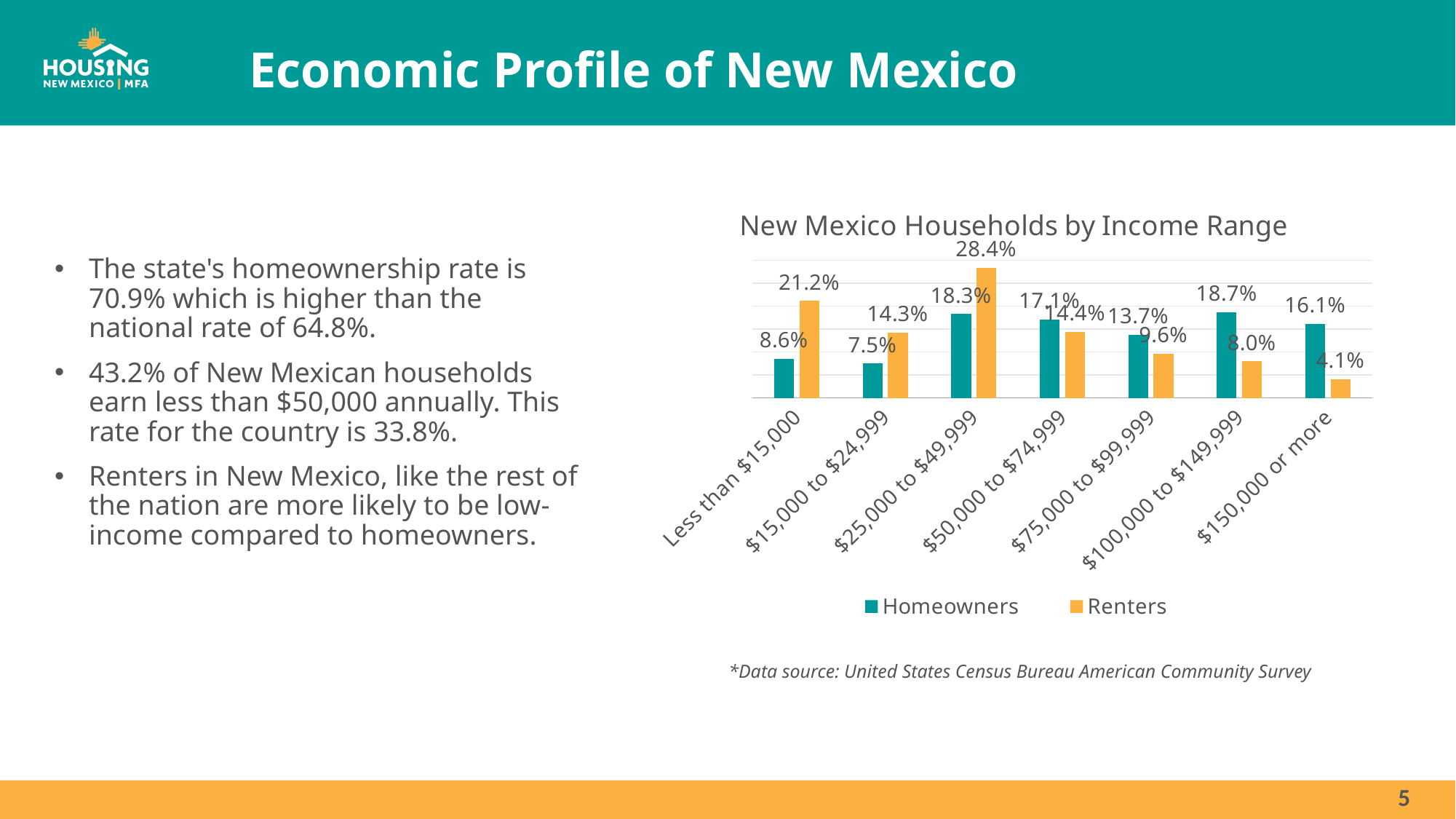
What is the difference between the Renters and Homeowners percentages for the Less than $15,000 income range? 12.6 percentage points What percentage of New Mexico renters are in the $25,000 to $49,999 income range? 28.4% What is the Homeowners value for the $75,000 to $99,999 income range? 13.7% Which income range has the lowest Renters percentage? $150,000 or more What is the Renters value for the $150,000 or more income range? 4.1% How many income ranges are shown on the x axis? 7 Which income range has the lowest Homeowners percentage? $15,000 to $24,999 In the $100,000 to $149,999 income range, which is larger: Homeowners or Renters? Homeowners What percentage of New Mexico homeowners earn less than $15,000? 8.6% What type of chart is shown on the slide? Bar chart Which income range has the highest Homeowners percentage? $100,000 to $149,999 How many series does the legend list? 2